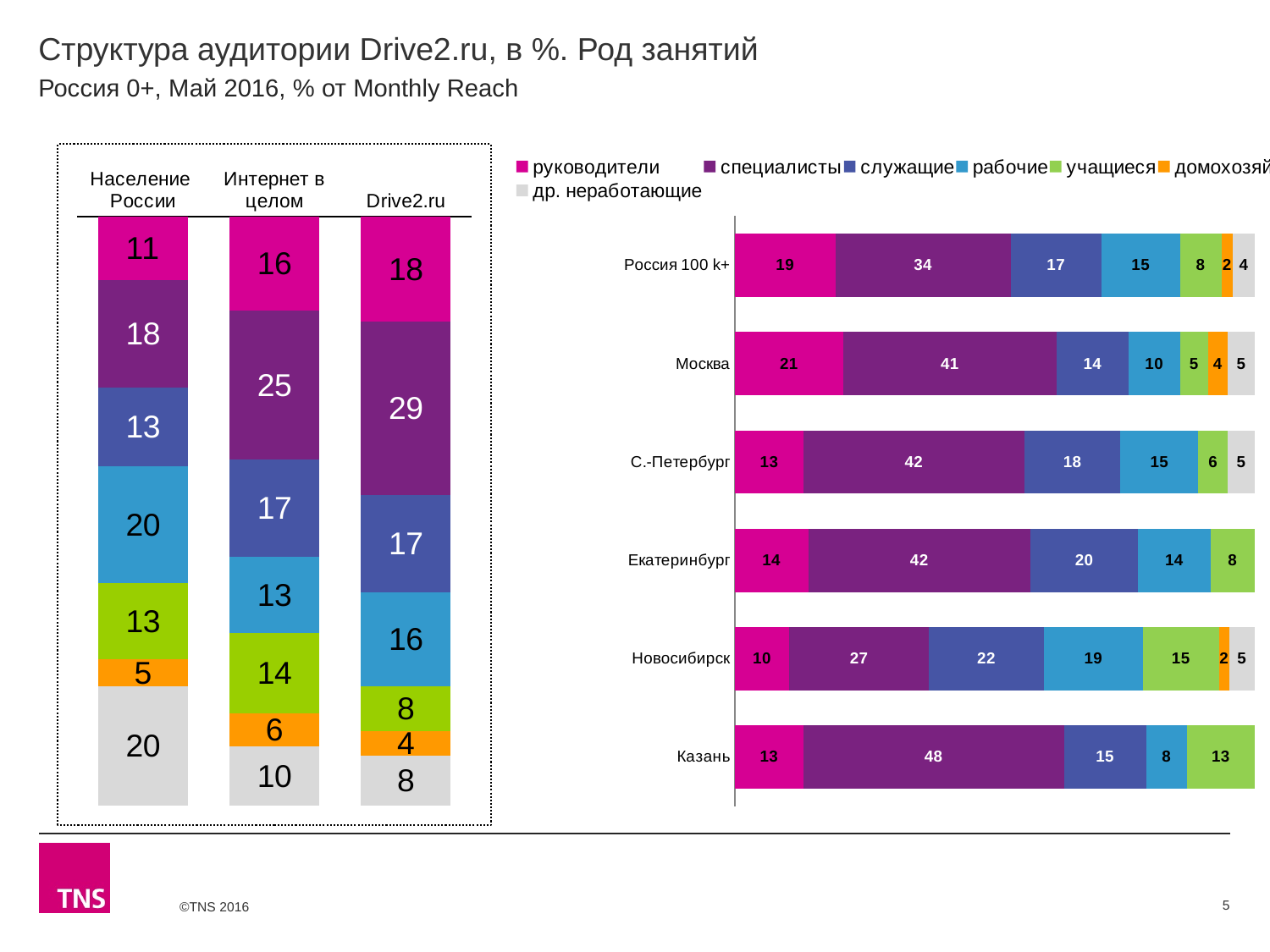
In the right chart, which city has the highest value for специалисты? Казань In the left chart, what is the value for рабочие in the Население России bar? 20 In the right chart, what is the value for служащие for Новосибирск? 22 In the right chart, which has the larger руководители value, Москва or С.-Петербург? Москва In the right chart, which category has the lowest value for руководители? Новосибирск How many categories (rows) are shown in the right chart? 6 In the left chart, what is the value for специалисты in the Drive2.ru bar? 29 In the left chart, what is the difference between the руководители value for Drive2.ru and for Население России? 7 In the right chart, what is the value for специалисты for Казань? 48 How many series does the legend list? 7 What kind of chart is the right chart? Stacked bar chart In the left chart, what is the value for учащиеся in the Интернет в целом bar? 14